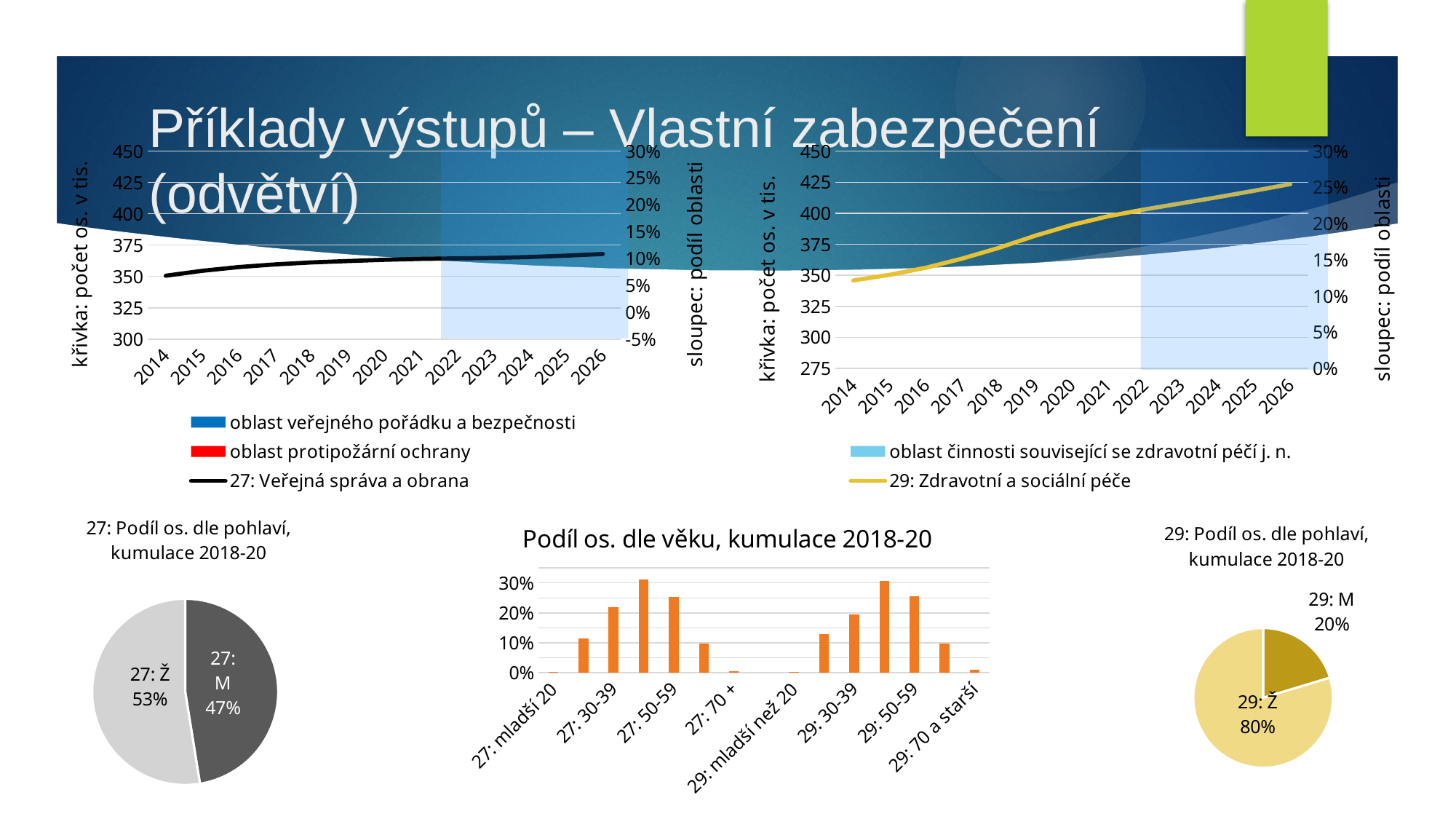
In the pie chart titled '27: Podíl os. dle pohlaví, kumulace 2018-20', what share is labelled for '27: Ž'? 53% In the chart titled 'Podíl os. dle věku, kumulace 2018-20', is the value for '29: 70 a starší' greater or less than 10%? less In the top-right chart, does the line '29: Zdravotní a sociální péče' rise or fall from 2014 to 2026? rise In the top-left chart, how many entries does the legend list? 3 In the pie chart titled '27: Podíl os. dle pohlaví, kumulace 2018-20', what is the value for '27: M'? 47% In the chart titled 'Podíl os. dle věku, kumulace 2018-20', is the value for '27: 50-59' greater or less than 20%? greater What kind of chart is the chart titled 'Podíl os. dle věku, kumulace 2018-20'? bar chart In the pie chart titled '29: Podíl os. dle pohlaví, kumulace 2018-20', what is the value for '29: Ž'? 80% In the pie chart titled '27: Podíl os. dle pohlaví, kumulace 2018-20', which slice is larger, '27: Ž' or '27: M'? 27: Ž In the pie chart titled '27: Podíl os. dle pohlaví, kumulace 2018-20', what is the difference between the '27: Ž' and '27: M' shares? 6% In the pie chart titled '29: Podíl os. dle pohlaví, kumulace 2018-20', what share is labelled for '29: M'? 20% In the top-right chart, is the value of the line '29: Zdravotní a sociální péče' in 2026 greater or less than 400? greater